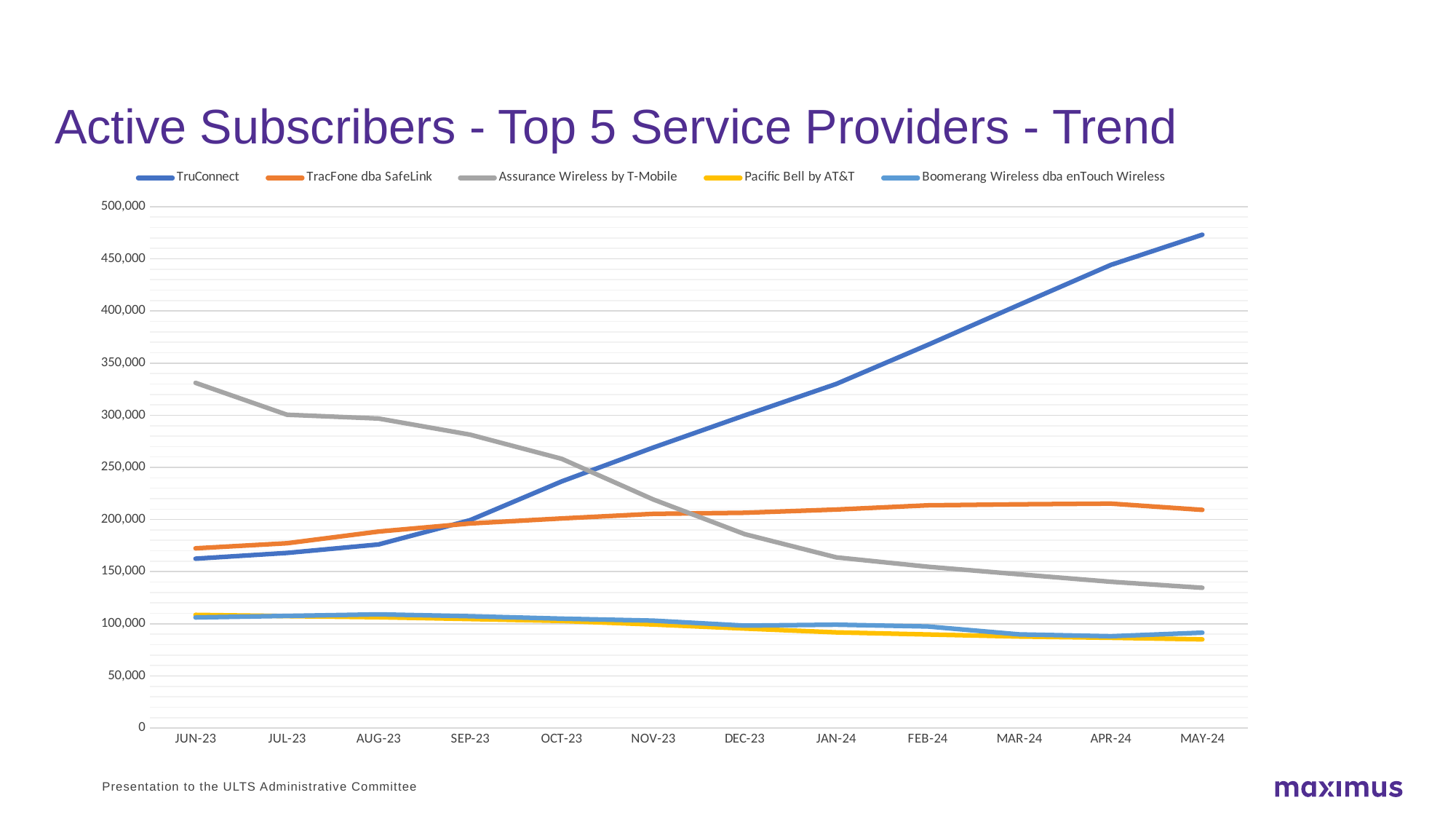
Which service provider has the highest number of active subscribers in JUN-23? Assurance Wireless by T-Mobile In DEC-23, which is larger: TruConnect or Assurance Wireless by T-Mobile? TruConnect Which service provider has the highest number of active subscribers in MAY-24? TruConnect How many months are shown along the x axis? 12 Does the Assurance Wireless by T-Mobile line rise or fall from JUN-23 to MAY-24? fall Is the value for Assurance Wireless by T-Mobile in MAY-24 greater or less than 150,000? less Is the value for Assurance Wireless by T-Mobile in JUN-23 greater or less than 300,000? greater Is the value for TruConnect in MAY-24 greater or less than 450,000? greater How many series does the legend list? 5 What is the title of the chart? Active Subscribers - Top 5 Service Providers - Trend What kind of chart is shown on the slide? line chart Does the TruConnect line rise or fall from JUN-23 to MAY-24? rise